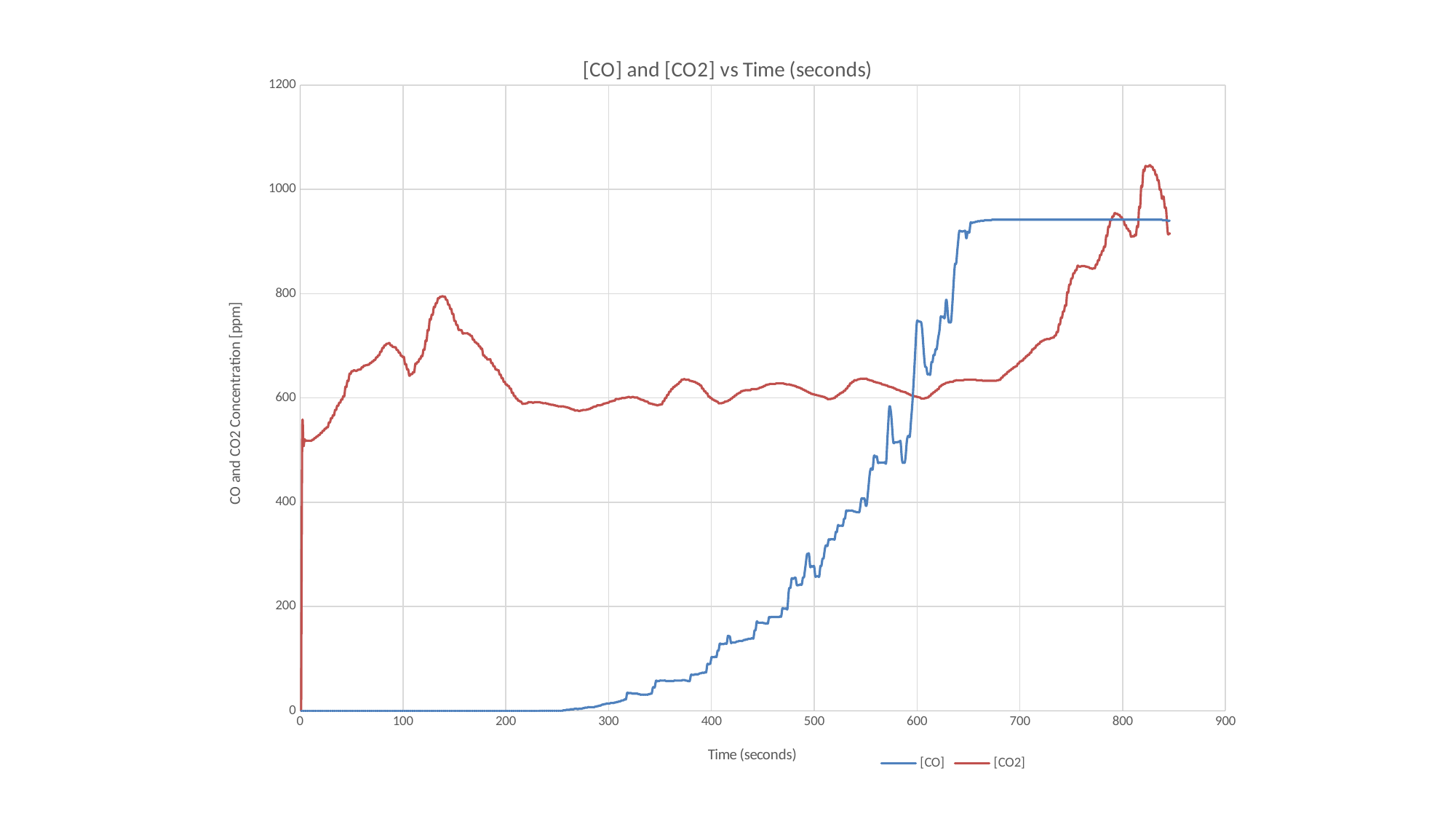
At 700 seconds, which series has the larger value, [CO] or [CO2]? [CO] What is the label of the vertical axis? CO and CO2 Concentration [ppm] Which series reaches the highest value on the chart? [CO2] Does the [CO] series rise or fall between 300 and 650 seconds? rise How many series does the legend list? 2 Is the value of [CO2] at 100 seconds greater or less than 600? greater What kind of chart is shown on the slide? line chart Is the value of [CO] at 700 seconds greater or less than 800? greater Is the value of [CO] at 300 seconds greater or less than 200? less What is the title of the chart? [CO] and [CO2] vs Time (seconds) At 400 seconds, which series has the larger value, [CO] or [CO2]? [CO2]